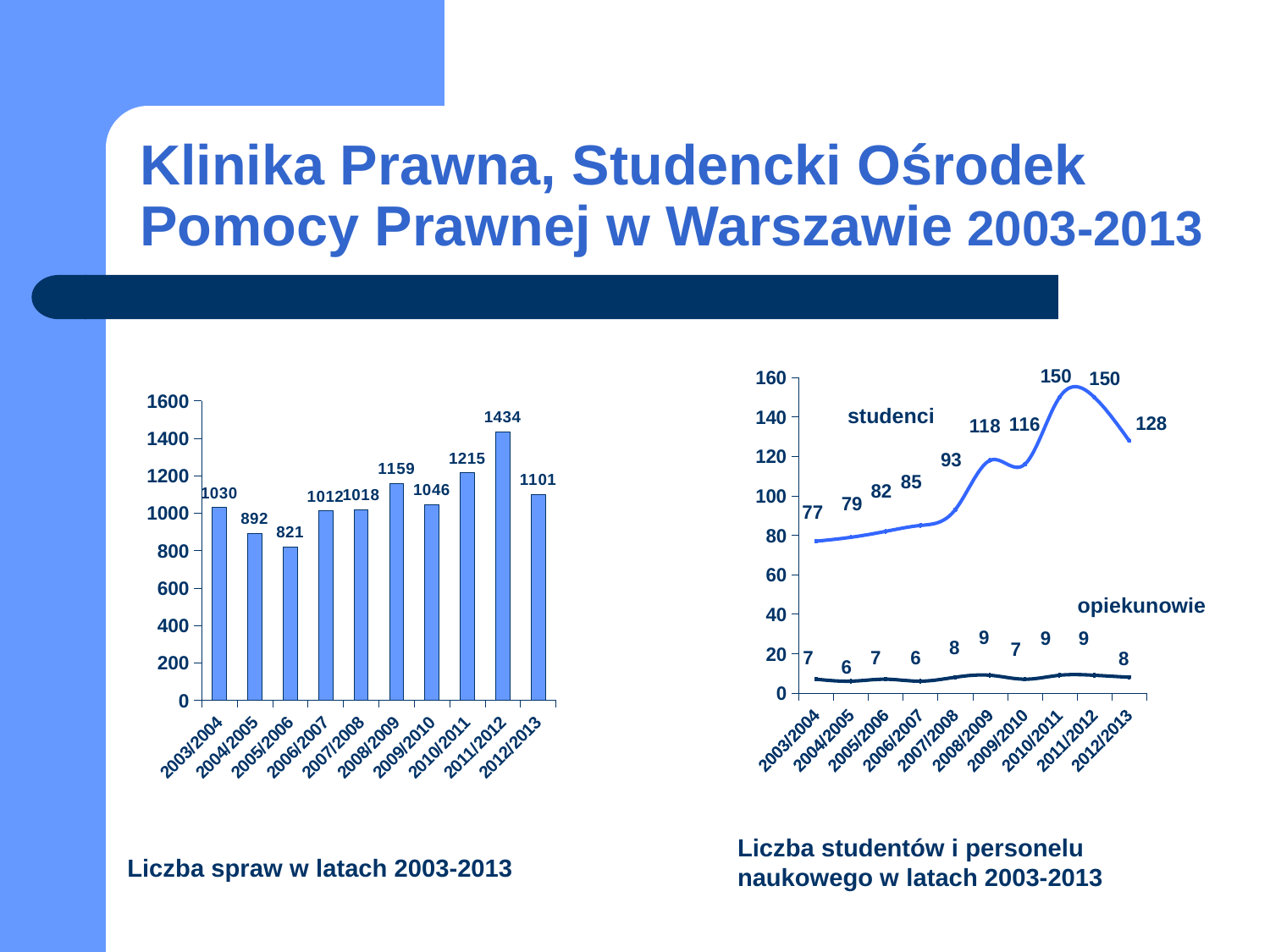
In the chart 'Liczba studentów i personelu naukowego w latach 2003-2013', what is the value for opiekunowie in 2012/2013? 8 In the chart 'Liczba spraw w latach 2003-2013', which year has the lowest value? 2005/2006 In the chart 'Liczba studentów i personelu naukowego w latach 2003-2013', what is the value for studenci in 2007/2008? 93 What kind of chart is 'Liczba studentów i personelu naukowego w latach 2003-2013'? line chart In the chart 'Liczba spraw w latach 2003-2013', what is the difference between the values for 2011/2012 and 2012/2013? 333 In the chart 'Liczba studentów i personelu naukowego w latach 2003-2013', how many series are plotted? 2 In the chart 'Liczba studentów i personelu naukowego w latach 2003-2013', which is larger: studenci in 2008/2009 or studenci in 2009/2010? 2008/2009 What kind of chart is 'Liczba spraw w latach 2003-2013'? bar chart In the chart 'Liczba studentów i personelu naukowego w latach 2003-2013', what is the difference between studenci in 2012/2013 and studenci in 2003/2004? 51 In the chart 'Liczba spraw w latach 2003-2013', what is the value for 2011/2012? 1434 In the chart 'Liczba spraw w latach 2003-2013', which year has the highest value? 2011/2012 In the chart 'Liczba spraw w latach 2003-2013', how many years are shown on the x axis? 10